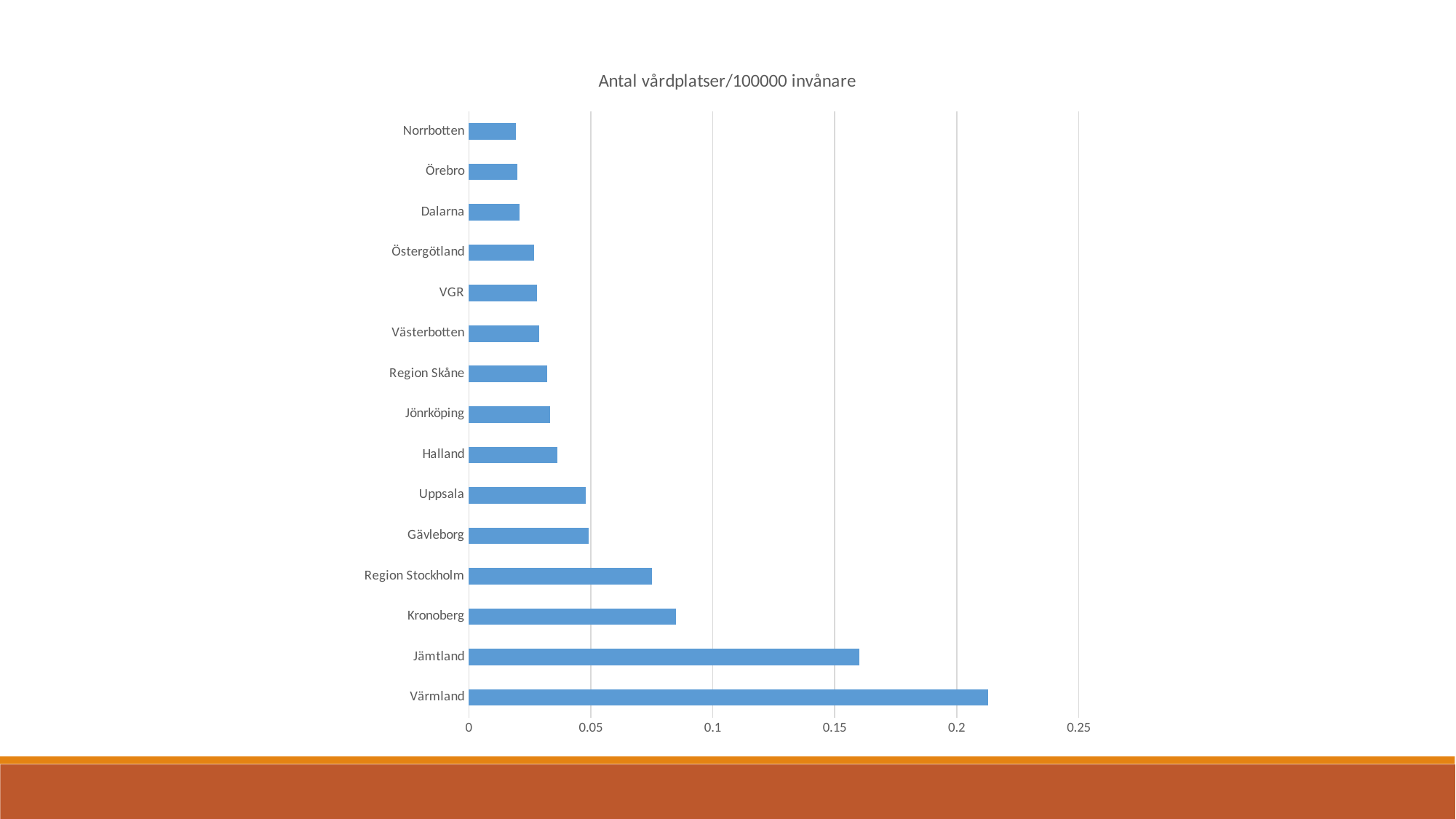
What is the title of the chart? Antal vårdplatser/100000 invånare Is the value for Jämtland greater or less than 0.15? greater Is the value for Värmland greater or less than 0.2? greater Is the value for Halland greater or less than 0.05? less Which region has the highest value in the chart? Värmland Which has a larger value, Region Stockholm or Dalarna? Region Stockholm Which has a larger value, Jämtland or Kronoberg? Jämtland How many regions are plotted in the chart? 15 What kind of chart is shown on the slide? bar chart